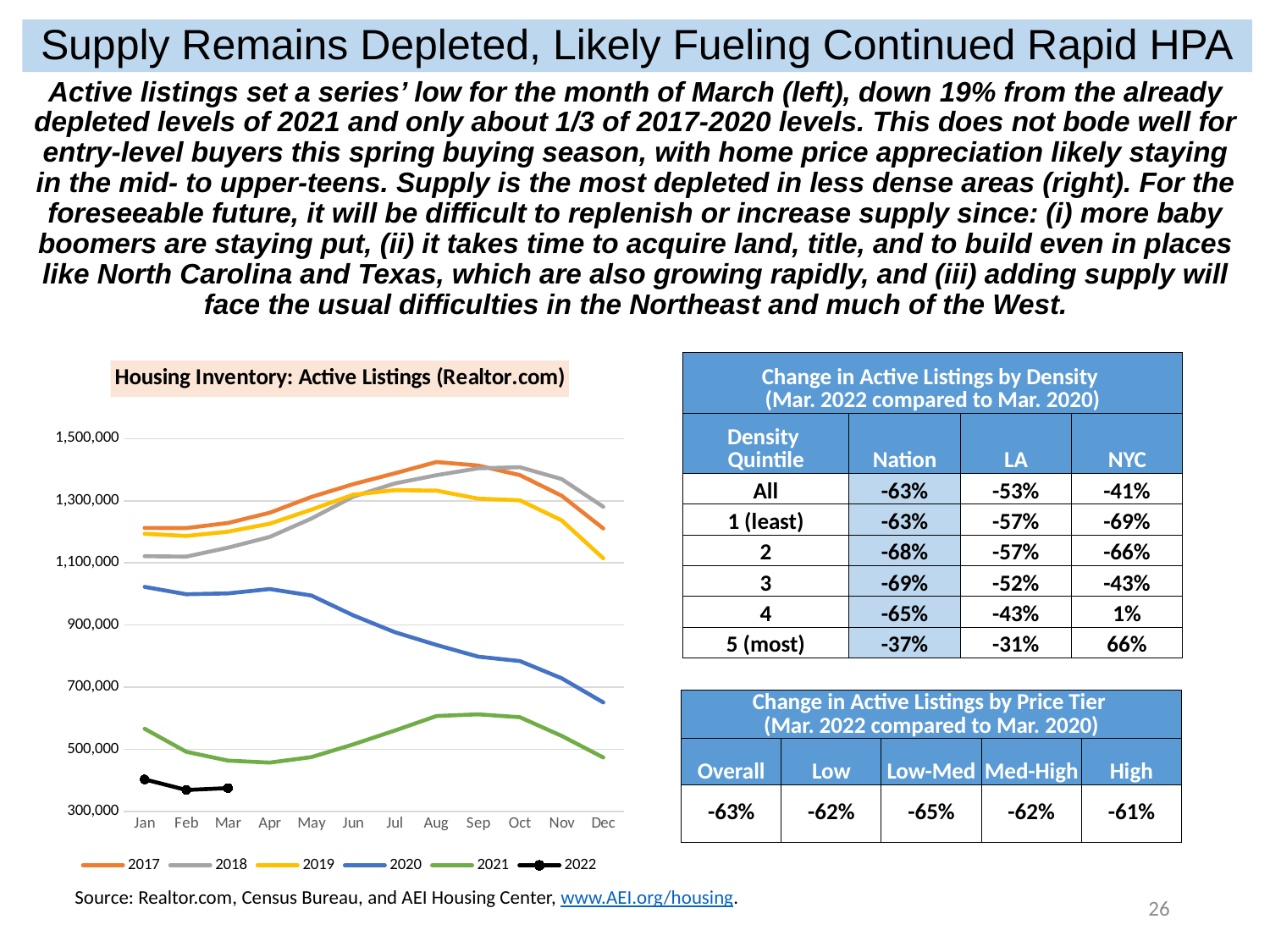
In the Housing Inventory chart, is the value for 2022 in Jan greater or less than 500,000? less In the Housing Inventory chart, which series has the lowest value in Jan? 2022 What kind of chart is the Housing Inventory: Active Listings chart? line chart In the Housing Inventory chart, is the value for 2017 in Aug greater or less than 1,300,000? greater In the Housing Inventory chart, which series has the lowest value in Dec? 2021 In the Housing Inventory chart, which is larger in Jan: the 2020 value or the 2021 value? 2020 In the Housing Inventory chart, is the value for 2020 in Jan greater or less than 900,000? greater How many months are shown along the x axis of the Housing Inventory chart? 12 In the Housing Inventory chart, does the 2020 series rise or fall from Jan to Dec? fall How many series does the legend of the Housing Inventory chart list? 6